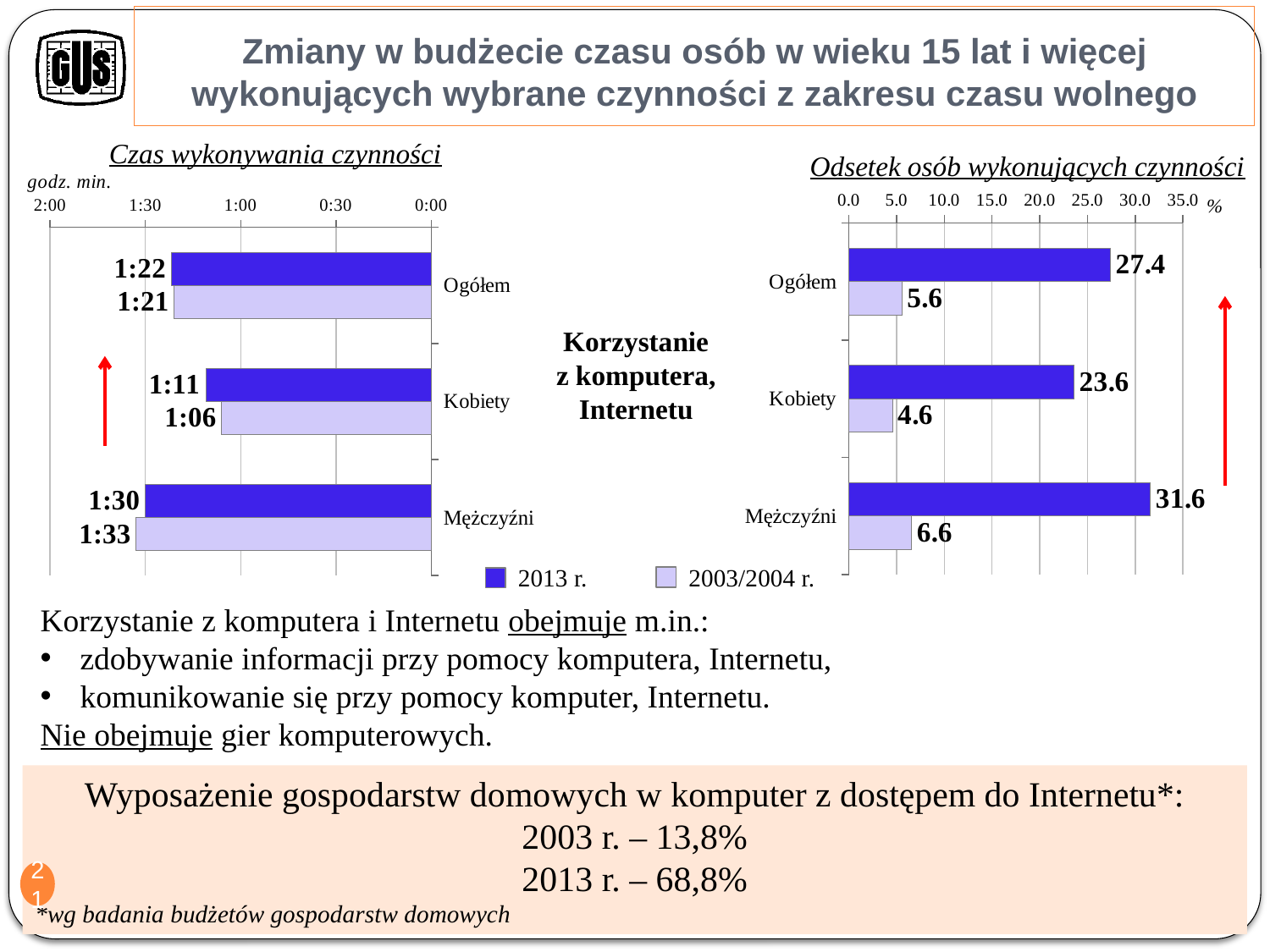
In the chart 'Odsetek osób wykonujących czynności', which category has the highest value for 2013 r.? Mężczyźni In the chart 'Odsetek osób wykonujących czynności', which is larger for Ogółem: the 2013 r. value or the 2003/2004 r. value? 2013 r. In the chart 'Odsetek osób wykonujących czynności', is the 2013 r. value for Kobiety greater or less than 20.0? greater What type of chart is 'Odsetek osób wykonujących czynności'? bar chart In the chart 'Czas wykonywania czynności', which category has the lowest value for 2013 r.? Kobiety How many categories are shown in the chart 'Czas wykonywania czynności'? 3 In the chart 'Odsetek osób wykonujących czynności', what is the value for Ogółem in 2013 r.? 27.4 How many series does the legend list for the charts on the slide? 2 In the chart 'Odsetek osób wykonujących czynności', what is the difference between the 2013 r. and 2003/2004 r. values for Mężczyźni? 25.0 In the chart 'Czas wykonywania czynności', what is the value for Mężczyźni in 2013 r.? 1:30 In the chart 'Czas wykonywania czynności', what is the value for Kobiety in 2003/2004 r.? 1:06 In the chart 'Odsetek osób wykonujących czynności', what is the value for Kobiety in 2003/2004 r.? 4.6